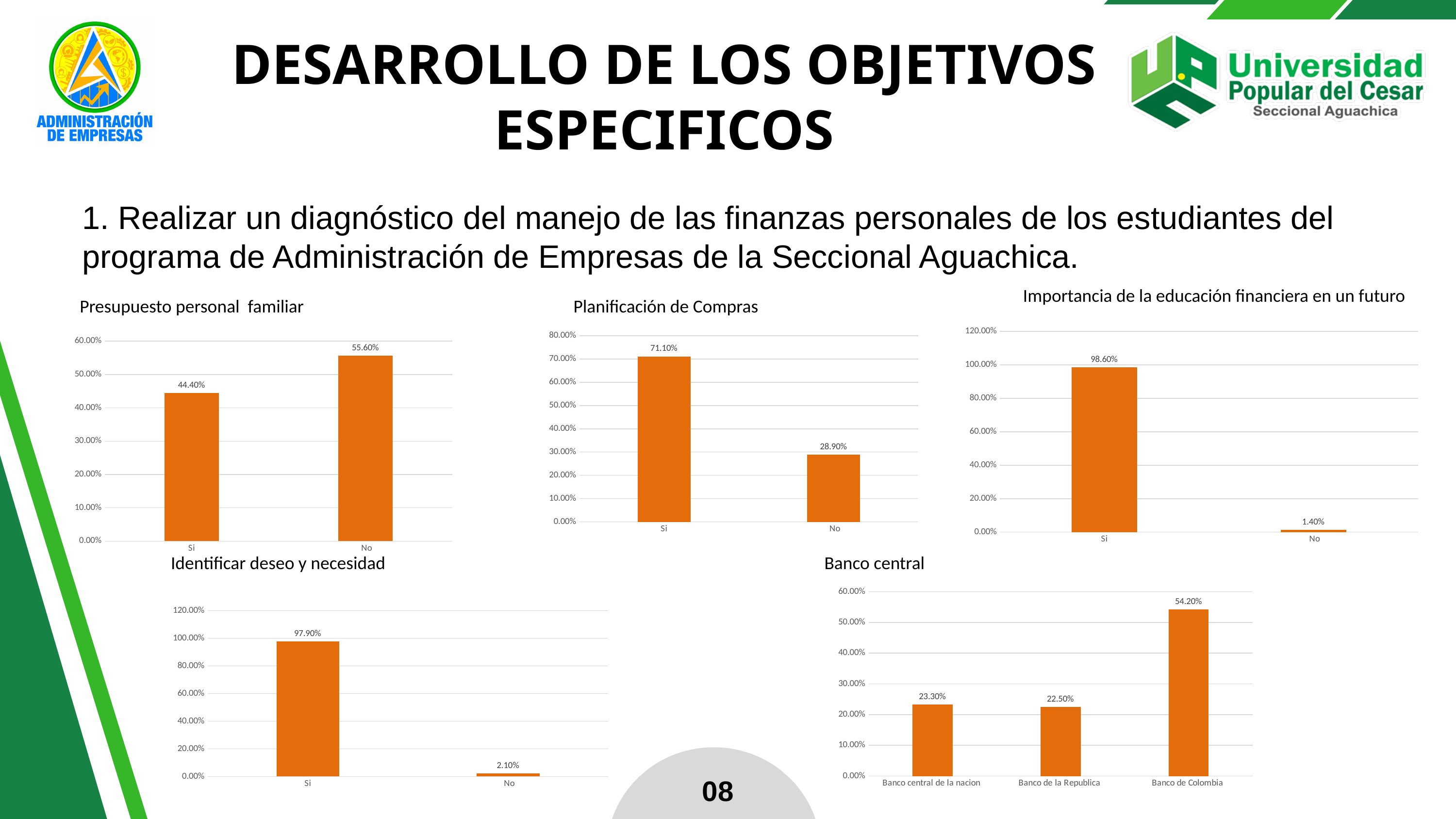
What type of chart is 'Planificación de Compras'? Bar chart In the 'Presupuesto personal familiar' chart, what is the value for 'Si'? 44.40% In the 'Importancia de la educación financiera en un futuro' chart, which category is highest? Si In the 'Importancia de la educación financiera en un futuro' chart, what is the value for 'No'? 1.40% In the 'Identificar deseo y necesidad' chart, what is the value for 'Si'? 97.90% In the 'Banco central' chart, which category has the highest value? Banco de Colombia In the 'Banco central' chart, what is the value for 'Banco de la Republica'? 22.50% In the 'Planificación de Compras' chart, what is the value for 'Si'? 71.10% In the 'Banco central' chart, what is the difference between 'Banco de Colombia' and 'Banco central de la nacion'? 30.90% In the 'Presupuesto personal familiar' chart, what is the value for 'No'? 55.60% In the 'Banco central' chart, how many categories are shown? 3 In the 'Planificación de Compras' chart, what is the difference between 'Si' and 'No'? 42.20%